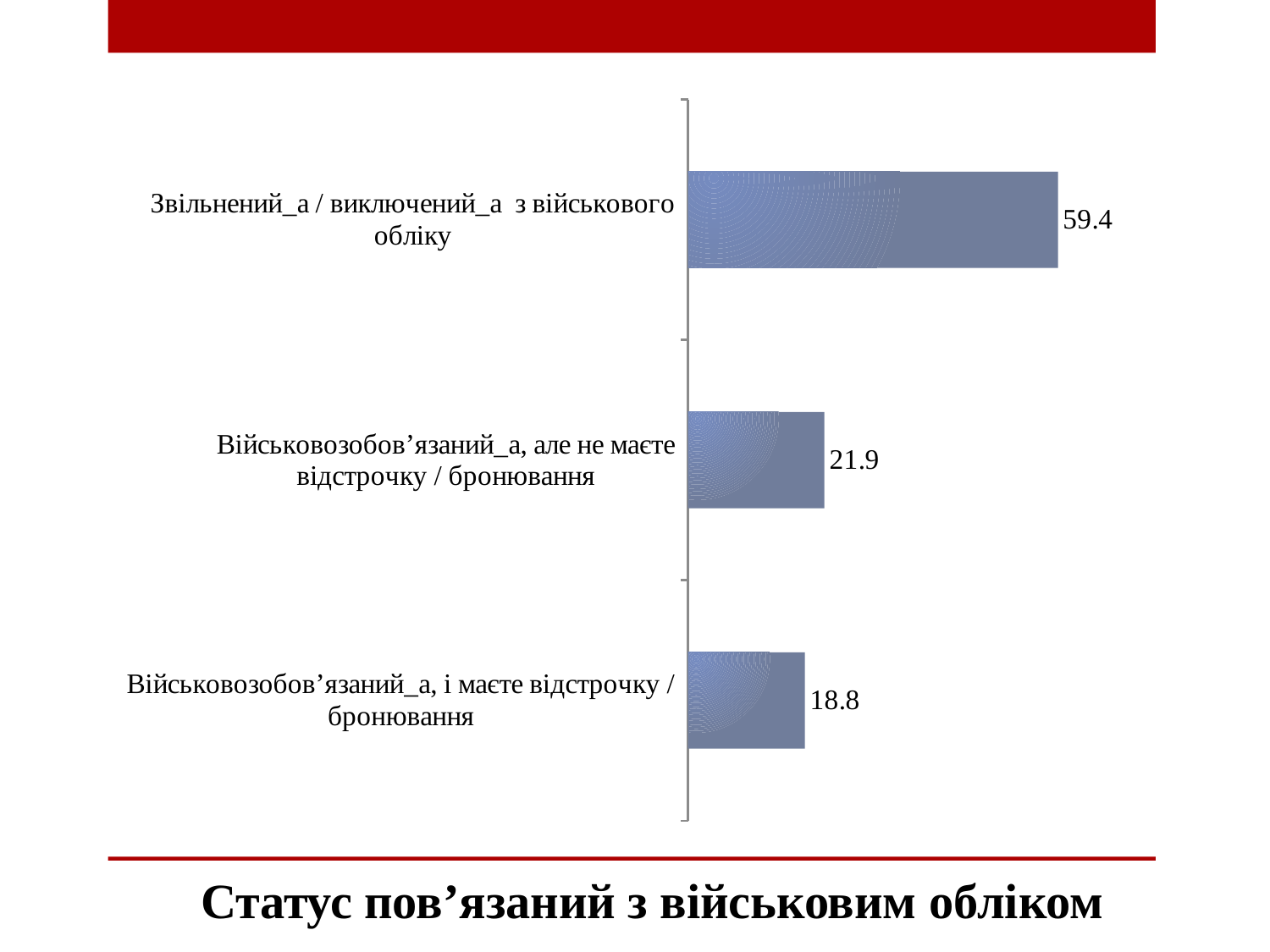
Which is larger: the value for "Військовозобов’язаний_а, але не маєте відстрочку / бронювання" or for "Військовозобов’язаний_а, і маєте відстрочку / бронювання"? Військовозобов’язаний_а, але не маєте відстрочку / бронювання What is the difference between the values for "Звільнений_а / виключений_а з військового обліку" and "Військовозобов’язаний_а, але не маєте відстрочку / бронювання"? 37.5 What is the title shown below the chart? Статус пов’язаний з військовим обліком How many categories are shown in the chart? 3 What is the value for "Військовозобов’язаний_а, і маєте відстрочку / бронювання"? 18.8 Which category has the lowest value? Військовозобов’язаний_а, і маєте відстрочку / бронювання What is the total of the three values shown in the chart? 100.1 What is the value for "Звільнений_а / виключений_а з військового обліку"? 59.4 Which category has the highest value? Звільнений_а / виключений_а з військового обліку What is the value for "Військовозобов’язаний_а, але не маєте відстрочку / бронювання"? 21.9 What kind of chart is shown on the slide? Bar chart What is the difference between the values for "Військовозобов’язаний_а, але не маєте відстрочку / бронювання" and "Військовозобов’язаний_а, і маєте відстрочку / бронювання"? 3.1